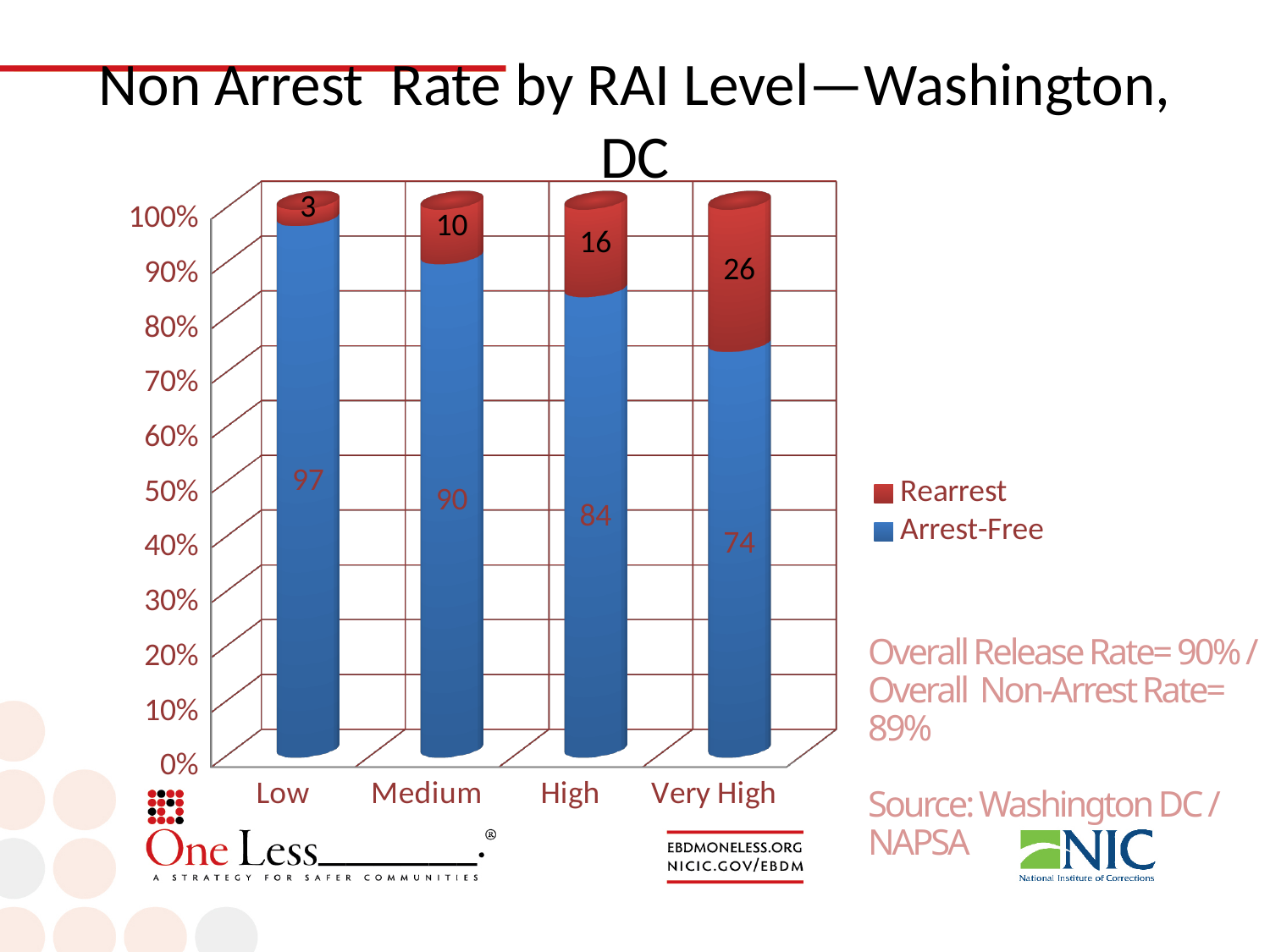
Which is larger, the Rearrest value for High or the Rearrest value for Medium? High How many RAI level categories are shown on the x axis? 4 What is the Arrest-Free value for the High RAI level? 84 What is the difference between the Arrest-Free values for Low and Very High? 23 What is the Rearrest value for the Medium RAI level? 10 Do the Rearrest values rise or fall as the RAI level goes from Low to Very High? Rise Which RAI level has the lowest Arrest-Free value? Very High What kind of chart is shown on the slide? Stacked bar chart What is the Rearrest value for the Very High RAI level? 26 How many series does the legend list? 2 Which RAI level has the highest Rearrest value? Very High What is the Arrest-Free value for the Low RAI level? 97